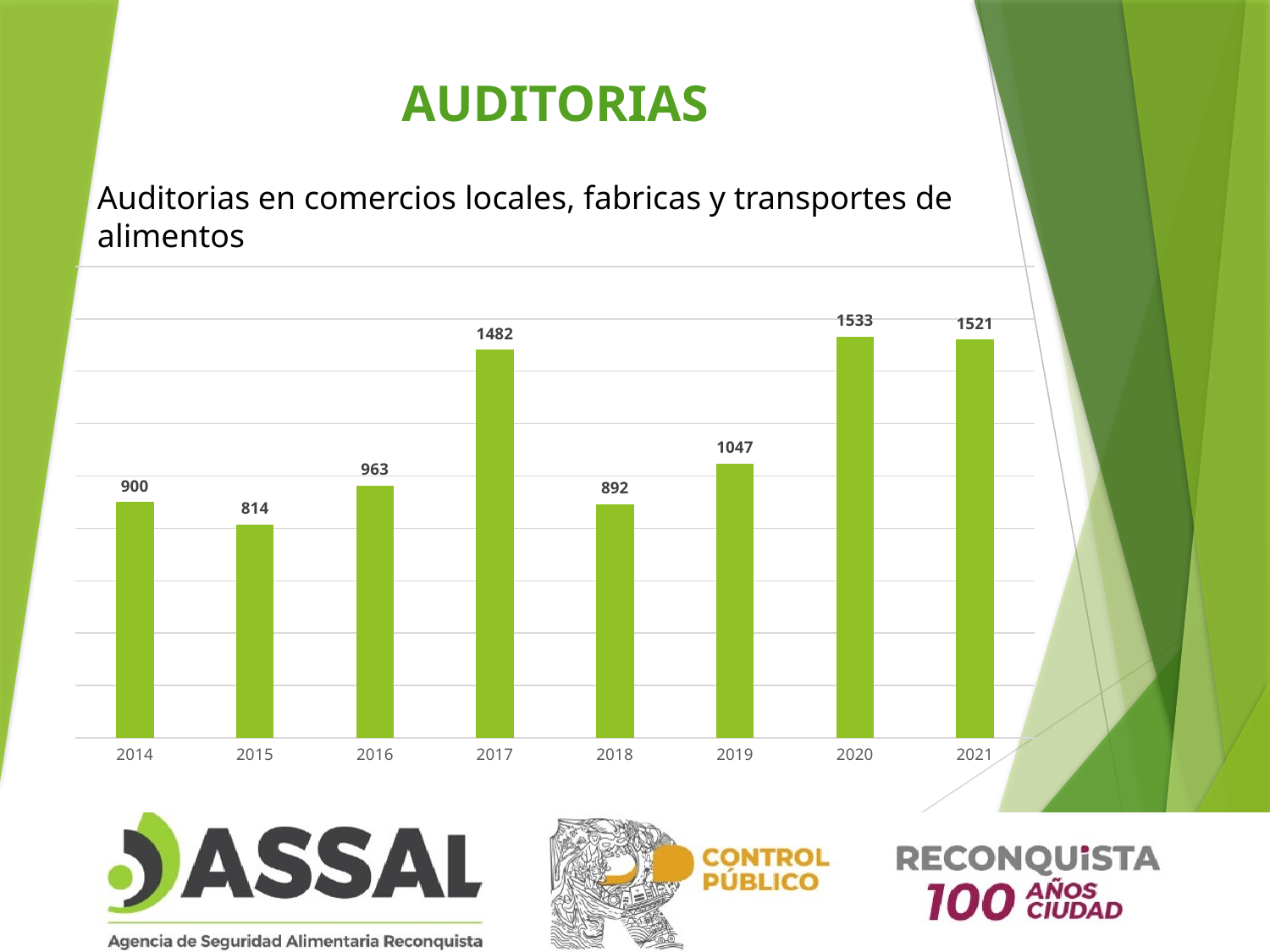
Do the values rise or fall from 2018 to 2020? rise What is the title of the slide above the chart? AUDITORIAS Which is larger, the value for 2014 or the value for 2018? 2014 What is the value for 2015? 814 How many years are shown on the x axis? 8 What is the value for 2017? 1482 What is the difference between the values for 2017 and 2018? 590 Which year has the lowest value? 2015 What kind of chart is shown on the slide? bar chart What is the value for 2019? 1047 What is the difference between the values for 2020 and 2021? 12 Which year has the highest value? 2020